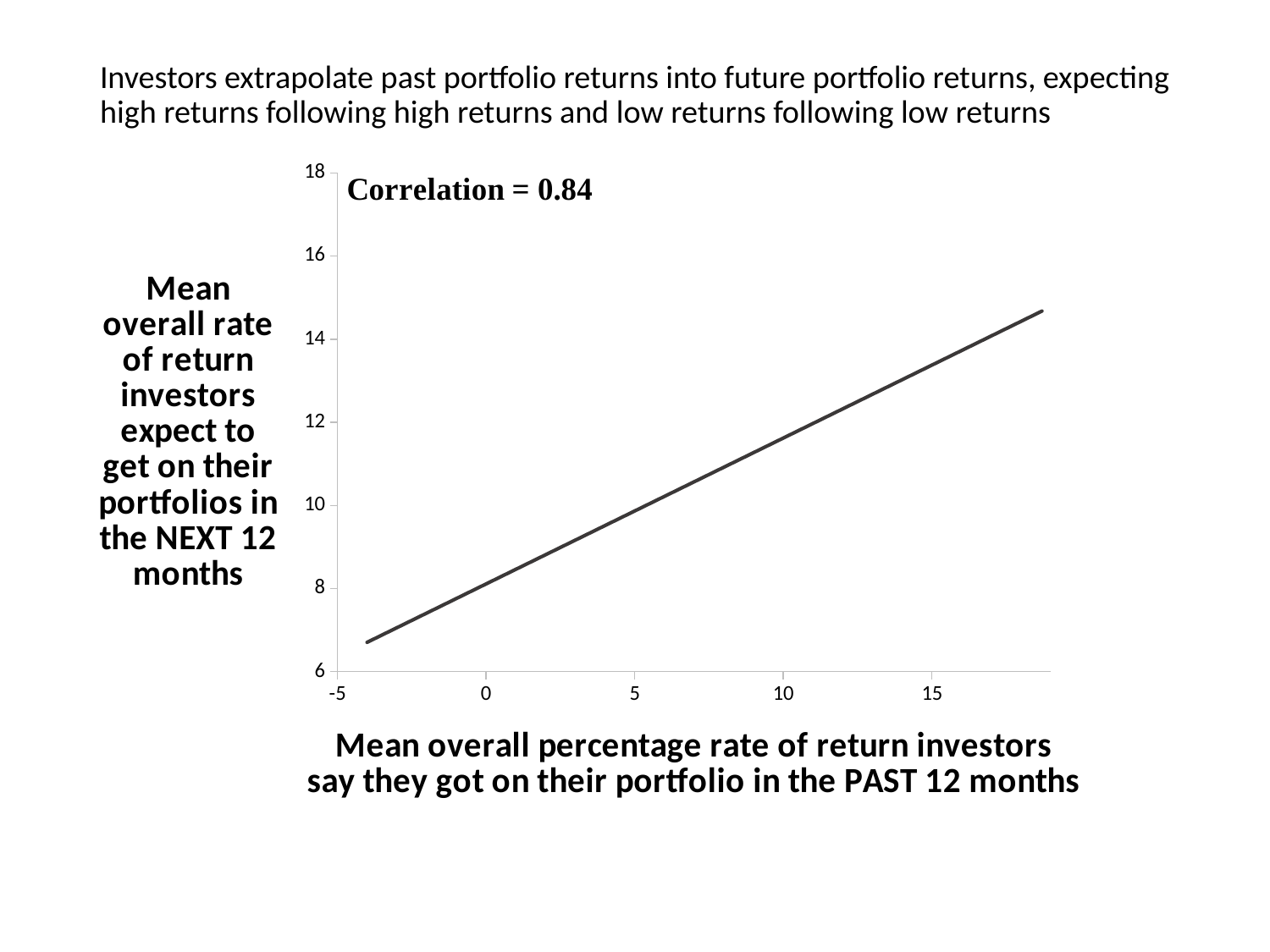
Is the expected return value where the line crosses a past return of 15 greater or less than 12? greater Do the values on the chart rise or fall as the past 12-month rate of return increases along the x axis? rise Which end of the line has the higher expected return value, the left end or the right end? right end Is the expected return value where the line crosses a past return of 10 greater or less than 10? greater Is the expected return value at the left end of the line greater or less than 8? less What correlation value is printed on the chart? 0.84 What kind of chart is shown on the slide? line chart What is the label of the x axis of the chart? Mean overall percentage rate of return investors say they got on their portfolio in the PAST 12 months